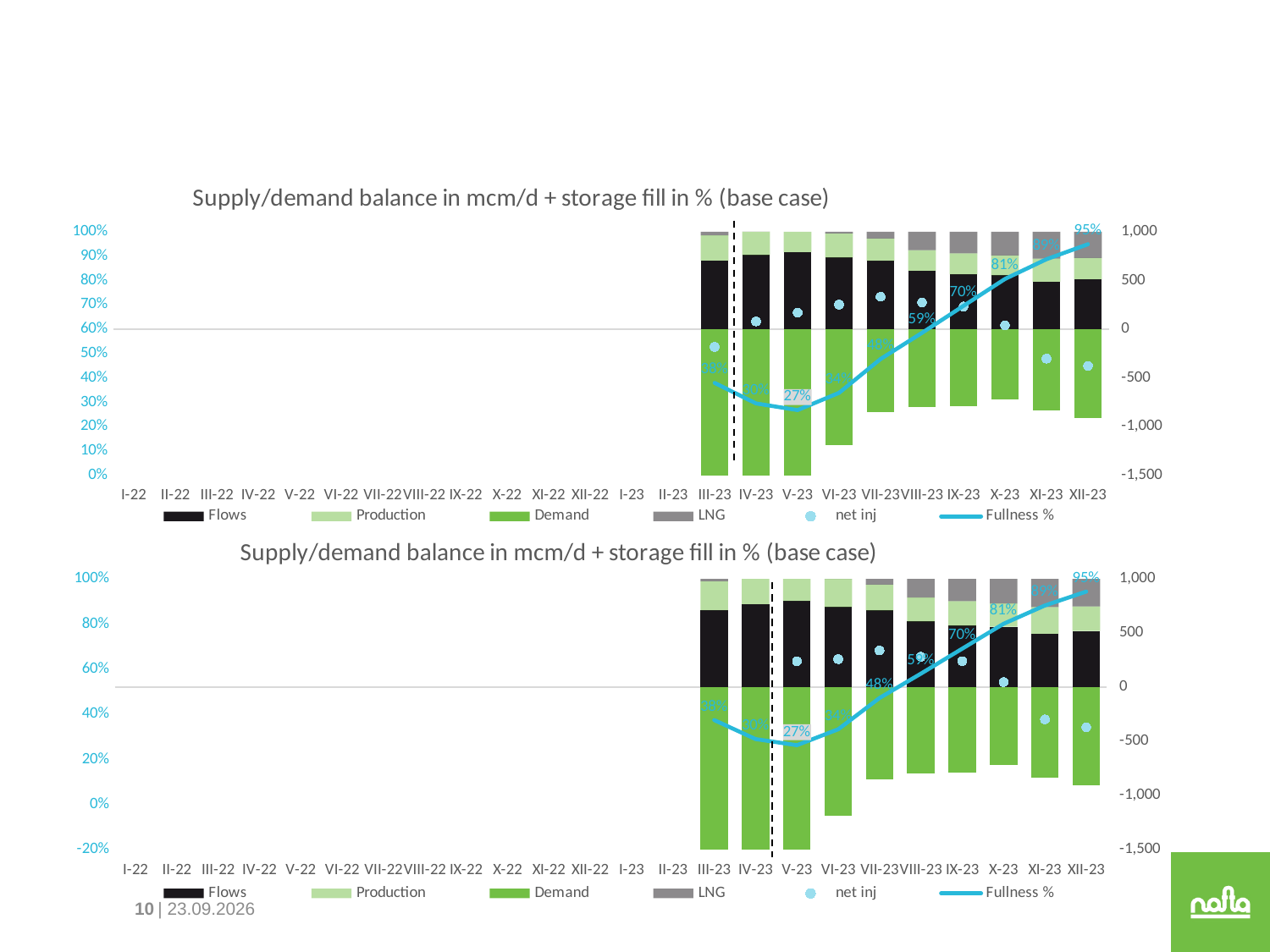
How many series does the legend of the top chart list? 6 In the top chart, what is the Fullness % value for IX-23? 70% In the top chart, what is the Fullness % value for XII-23? 95% How many months are labelled on the x axis of the top chart? 24 In the top chart, which month has the highest Fullness % value? XII-23 In the bottom chart, does the Fullness % line rise or fall from V-23 to XII-23? rise In the top chart, what is the Fullness % value for V-23? 27% In the top chart, which month has the lowest Fullness % value? V-23 In the bottom chart, what is the Fullness % value for VIII-23? 59% In the top chart, which has the higher Fullness % value, IX-23 or VII-23? IX-23 In the bottom chart, what is the Fullness % value for X-23? 81% In the bottom chart, what is the difference between the Fullness % for XII-23 and for V-23? 68 percentage points